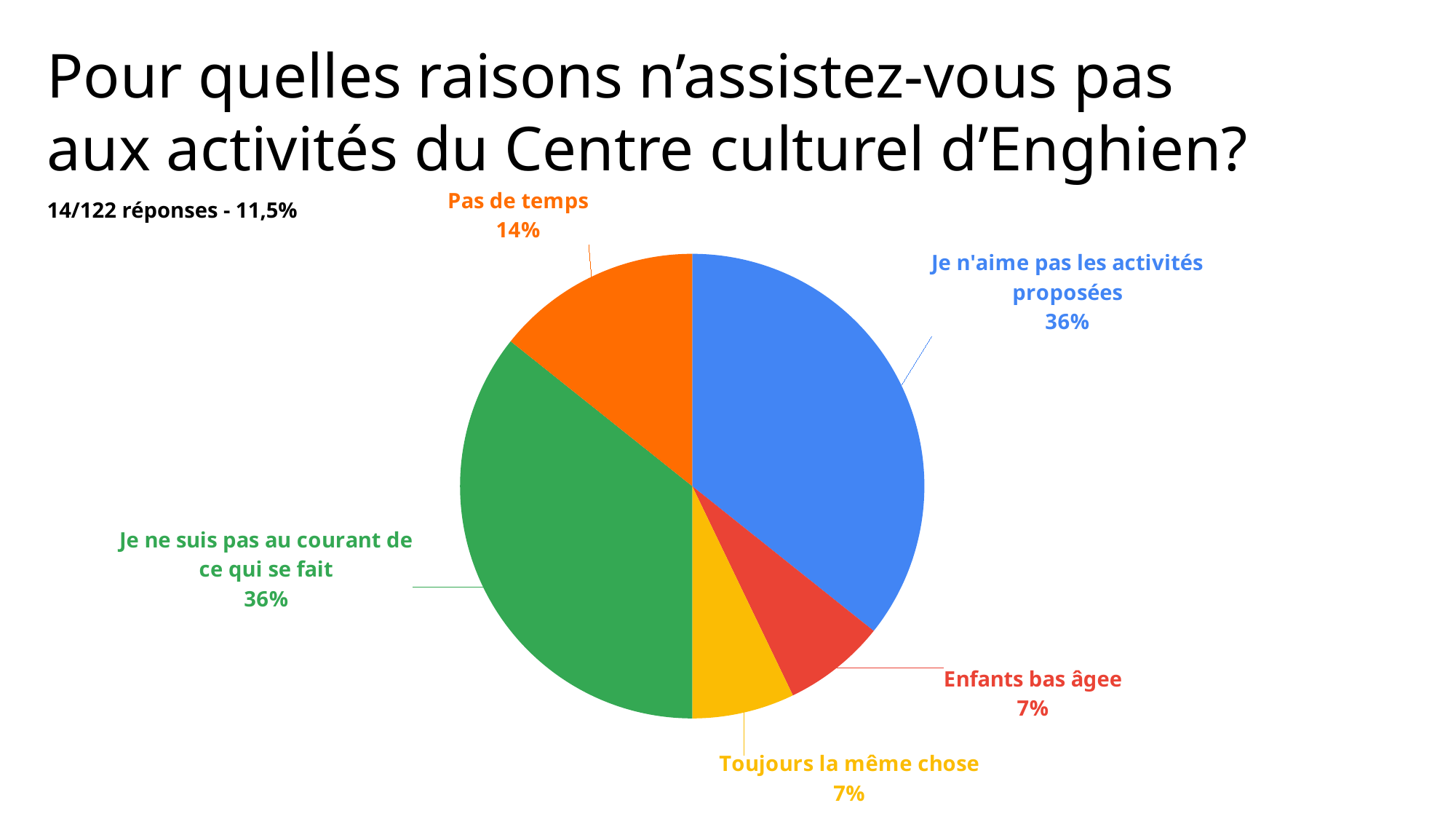
What percentage is shown for "Toujours la même chose"? 7% What is the difference in percentage points between "Pas de temps" and "Toujours la même chose"? 7 percentage points What kind of chart is shown on the slide? Pie chart What percentage is shown for "Enfants bas âgee"? 7% What percentage is shown for "Je n'aime pas les activités proposées"? 36% What share of the pie does "Je ne suis pas au courant de ce qui se fait" represent? 36% Which is larger, the share for "Pas de temps" or the share for "Enfants bas âgee"? Pas de temps What is the difference in percentage points between "Je n'aime pas les activités proposées" and "Pas de temps"? 22 percentage points How many slices does the pie chart have? 5 What colour is the slice for "Je ne suis pas au courant de ce qui se fait"? Green How many responses does the slide say the chart is based on? 14/122 réponses - 11,5% What share of the pie does "Pas de temps" represent? 14%